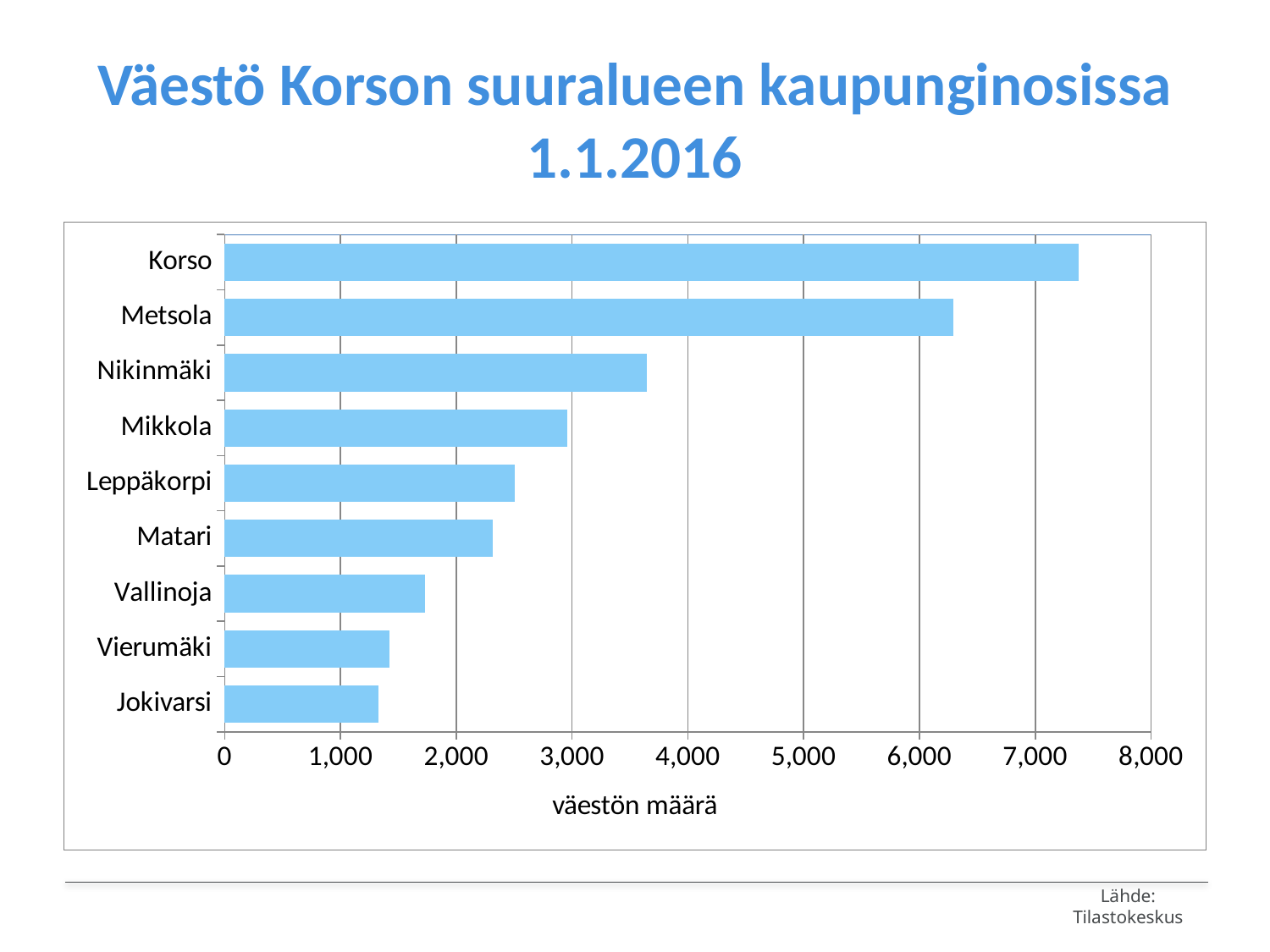
Which has a larger population, Metsola or Nikinmäki? Metsola Is the value for Nikinmäki greater or less than 3,000? greater How many city districts (categories) are shown in the chart? 9 Which has a larger population, Leppäkorpi or Matari? Leppäkorpi What is the label on the horizontal axis of the chart? väestön määrä Is the value for Vallinoja greater or less than 2,000? less Which district has the largest population in the chart? Korso Is the value for Metsola greater or less than 6,000? greater What kind of chart is shown on the slide? bar chart